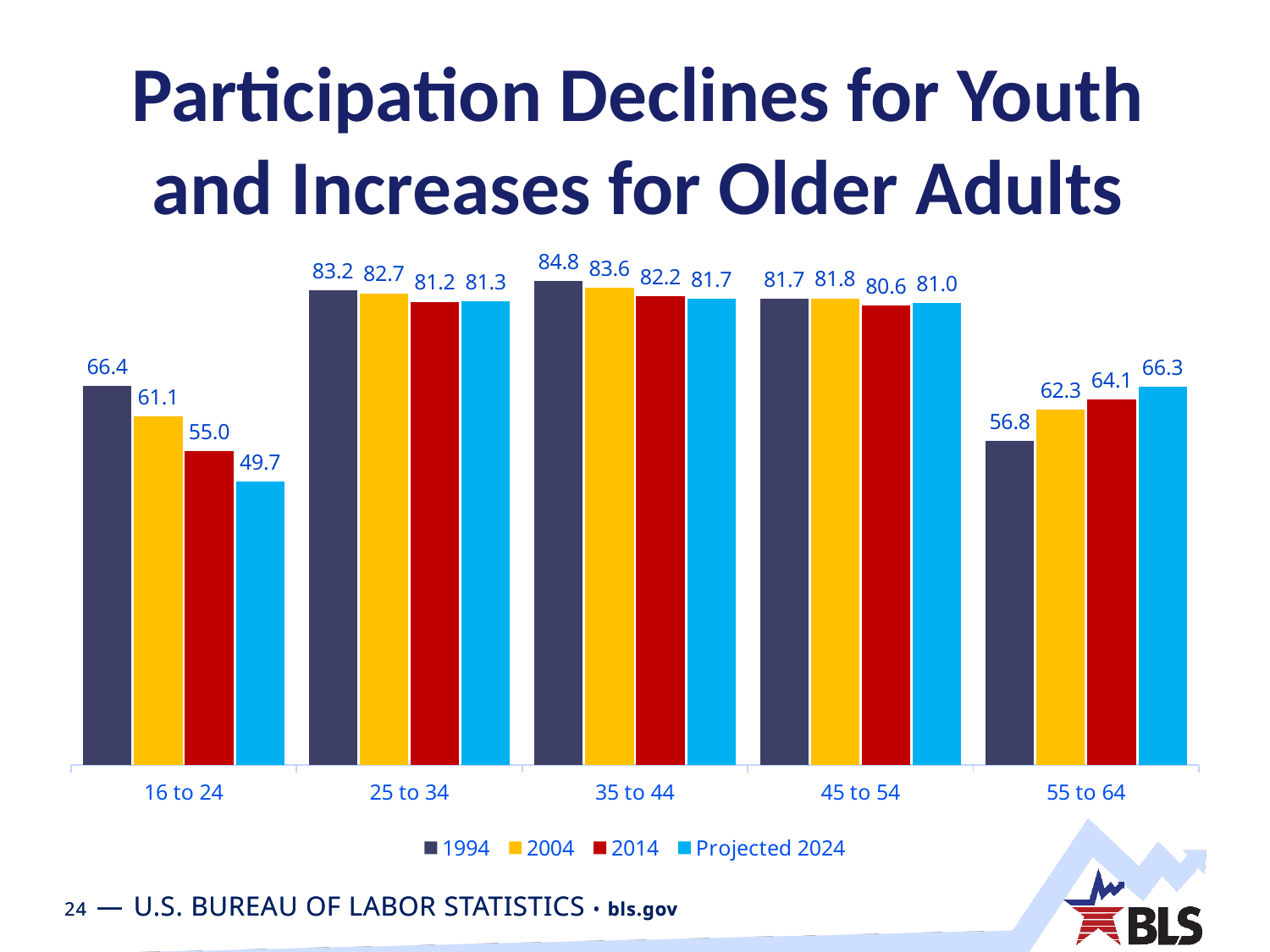
What is the difference between the Projected 2024 and 1994 values for the 55 to 64 age group? 9.5 Which is larger for the 45 to 54 age group: the 2004 value or the 2014 value? 2004 How many age groups are shown on the x axis? 5 What kind of chart is shown on the slide? Bar chart What is the difference between the 1994 and Projected 2024 values for the 16 to 24 age group? 16.7 What is the 2014 value for the 35 to 44 age group? 82.2 Which age group has the highest value in 1994? 35 to 44 Do the values for the 16 to 24 age group rise or fall from 1994 to Projected 2024? Fall Which age group has the lowest Projected 2024 value? 16 to 24 How many series does the legend list? 4 What is the value for the 16 to 24 age group in 1994? 66.4 What is the Projected 2024 value for the 55 to 64 age group? 66.3